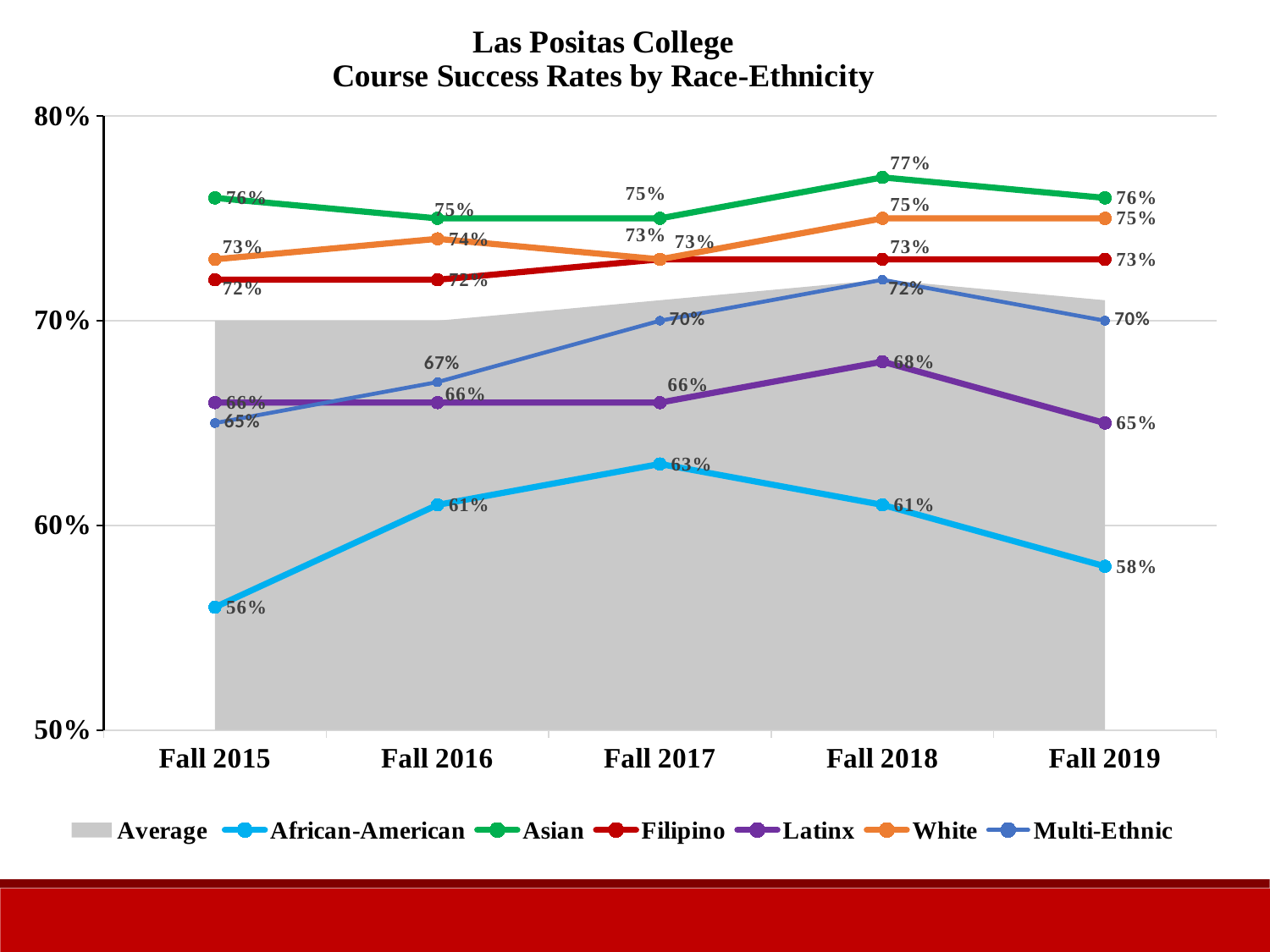
What is the course success rate for Multi-Ethnic students in Fall 2017? 70% How many series does the legend list? 7 Is the Average value for Fall 2015 greater or less than 60%? greater Which group has the highest course success rate in Fall 2019? Asian Which group has the lowest course success rate in Fall 2019? African-American What is the difference between the Asian and African-American success rates in Fall 2019? 18 percentage points What is the course success rate for Asian students in Fall 2018? 77% What kind of chart is shown on the slide? a combination line and area chart (lines for each group with a shaded area for the average) What is the course success rate for African-American students in Fall 2015? 56% Does the African-American success rate rise or fall from Fall 2017 to Fall 2019? fall How many semesters are shown on the x axis? 5 In Fall 2016, which group has the higher success rate, White or Filipino? White